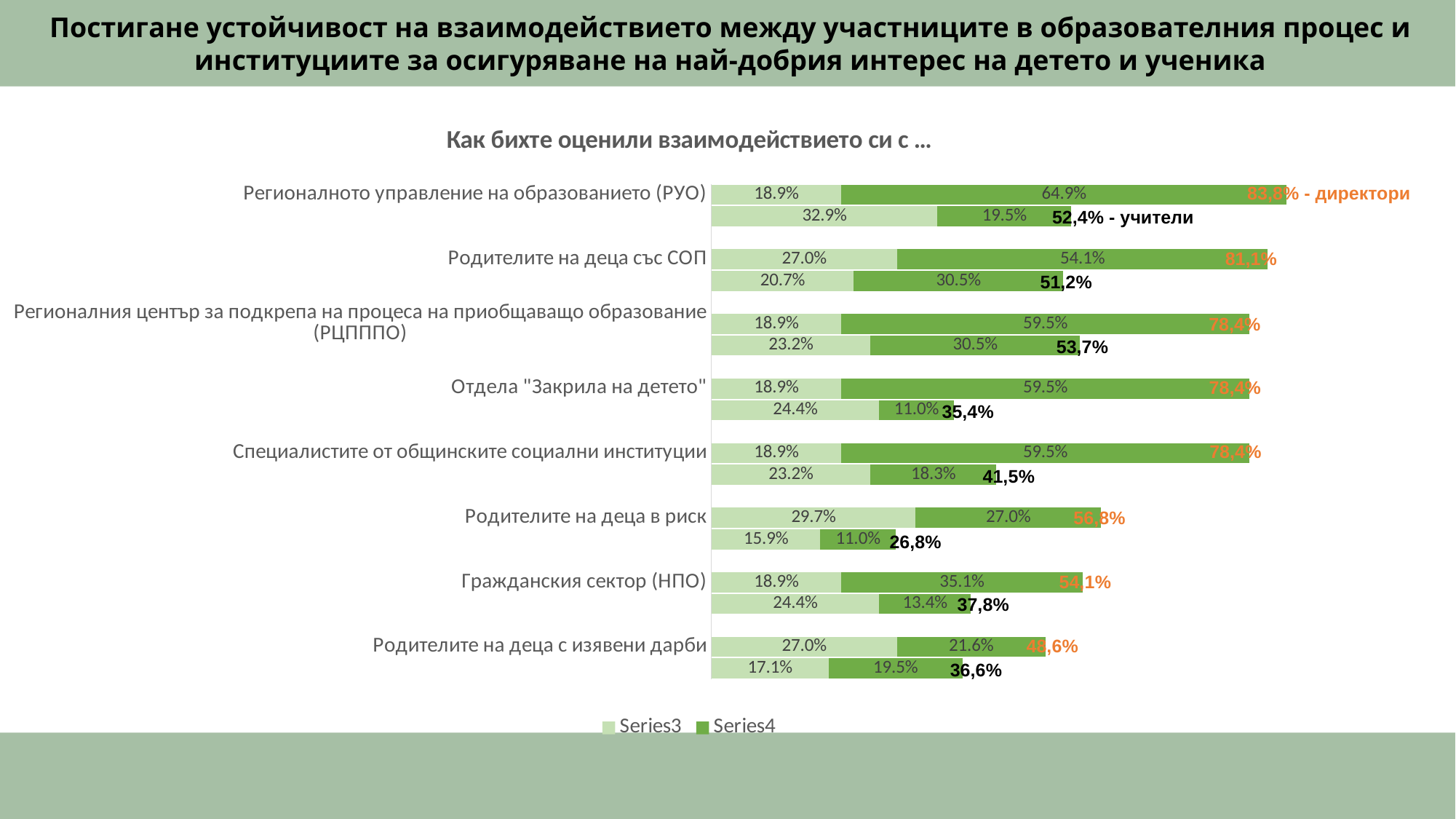
What is the difference between the directors' total and the teachers' total for Гражданския сектор (НПО)? 16,3% How many categories (institutions) are listed on the chart? 8 For Родителите на деца с изявени дарби, which is larger: the directors' total or the teachers' total? Directors' total What is the Series4 value in the directors' bar for Регионалното управление на образованието (РУО)? 64.9% What kind of chart is shown on the slide? Stacked bar chart What is the title of the chart? Как бихте оценили взаимодействието си с … What is the total of the directors' bar for Родителите на деца със СОП? 81,1% What is the total of the teachers' bar for Отдела "Закрила на детето"? 35,4% Which category has the lowest teachers' total? Родителите на деца в риск Which category has the highest directors' total? Регионалното управление на образованието (РУО) What is the Series3 value in the teachers' bar for Родителите на деца в риск? 15.9% How many series does the legend list? 2